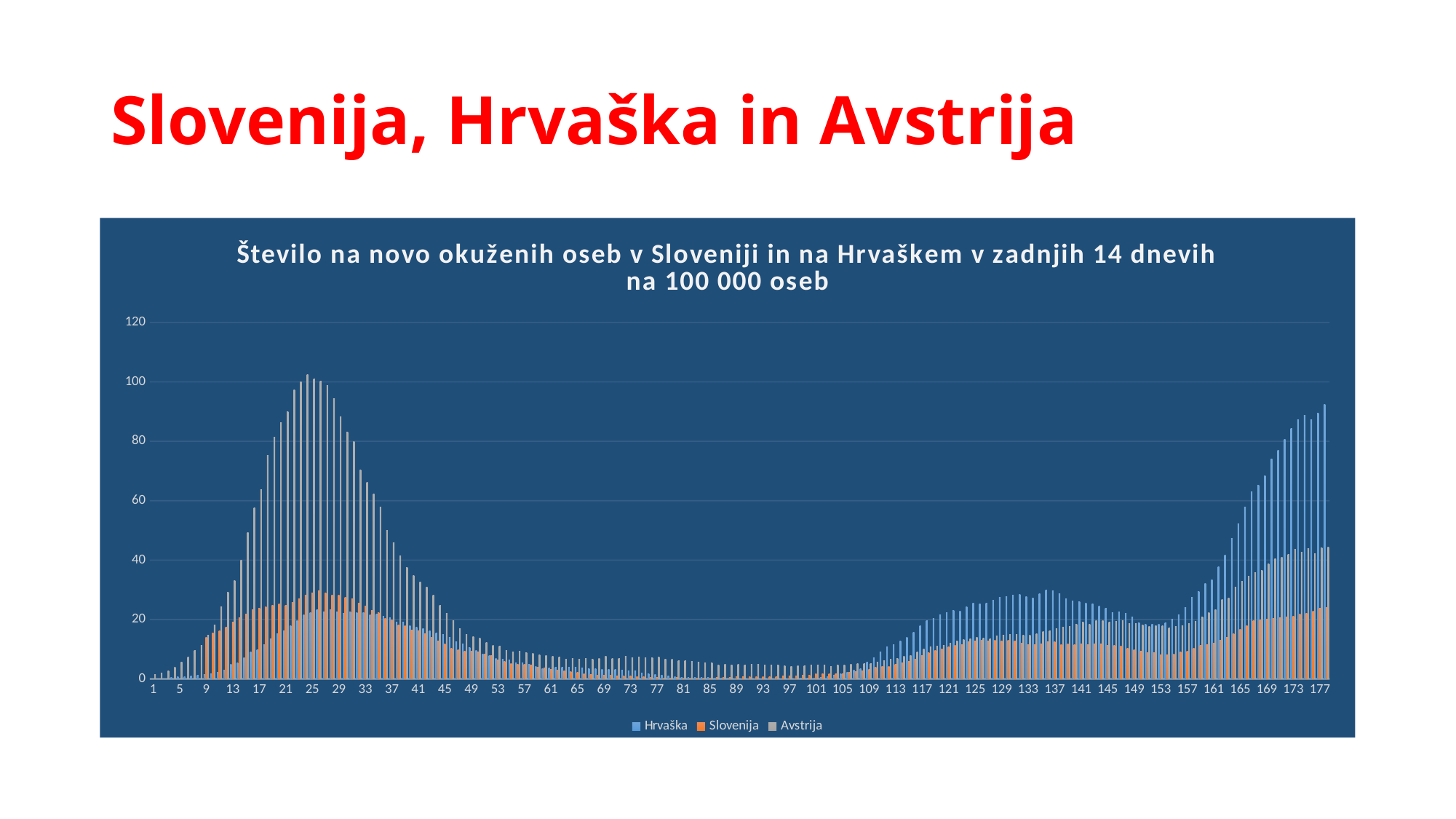
At day 25, which is larger, the value for Avstrija or the value for Slovenija? Avstrija Is the value for Slovenija at day 177 greater or less than 40? less Which series are listed in the legend? Hrvaška, Slovenija, Avstrija How many series does the legend list? 3 What is the last label on the horizontal axis? 177 Do the values for Hrvaška rise or fall between day 157 and day 177? rise Is the highest value for Slovenija greater or less than 40? less What kind of chart is shown on the slide? bar chart Is the peak value for Avstrija (around day 25) greater or less than 80? greater What is the highest value shown on the vertical axis? 120 Which series reaches the highest value anywhere on the chart? Avstrija